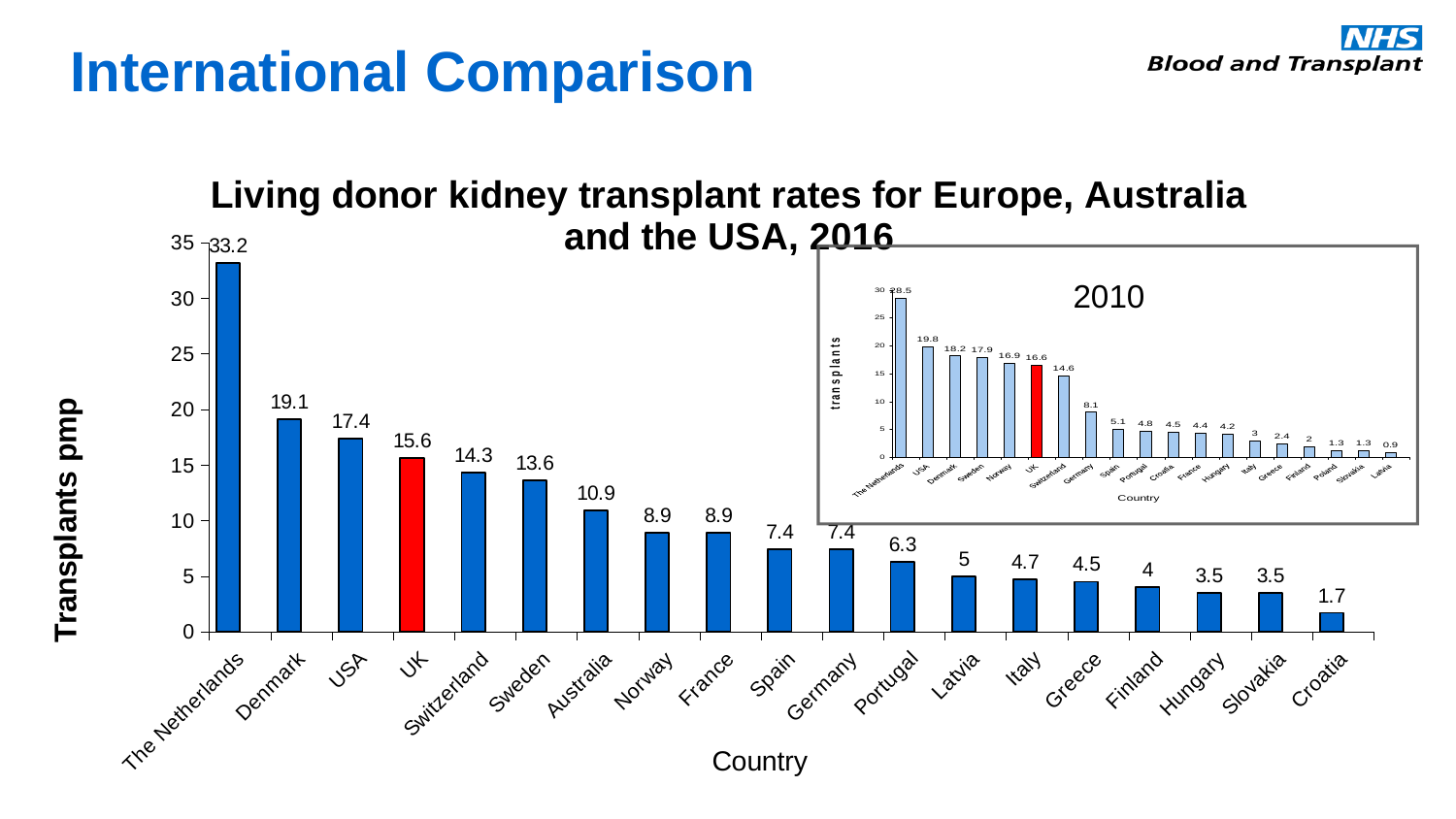
In the 2016 chart, which country has the lowest transplant rate? Croatia In the 2016 chart, what is the difference between the transplant rates of The Netherlands and Denmark? 14.1 In the 2016 chart, what is the transplant rate for Australia? 10.9 In the inset 2010 chart, what is the transplant rate for the UK? 16.6 In the 2016 chart, which has the higher transplant rate, the USA or Switzerland? USA In the inset 2010 chart, what is the transplant rate for The Netherlands? 28.5 What type of chart is the main 2016 chart? Bar chart In the 2016 chart, which bar is coloured red? UK In the 2016 chart, how many countries are shown on the x axis? 19 In the 2016 chart, what is the living donor kidney transplant rate (pmp) for the UK? 15.6 In the 2016 chart, which country has the highest transplant rate? The Netherlands In the 2016 chart, do the values rise or fall from left to right along the x axis? Fall